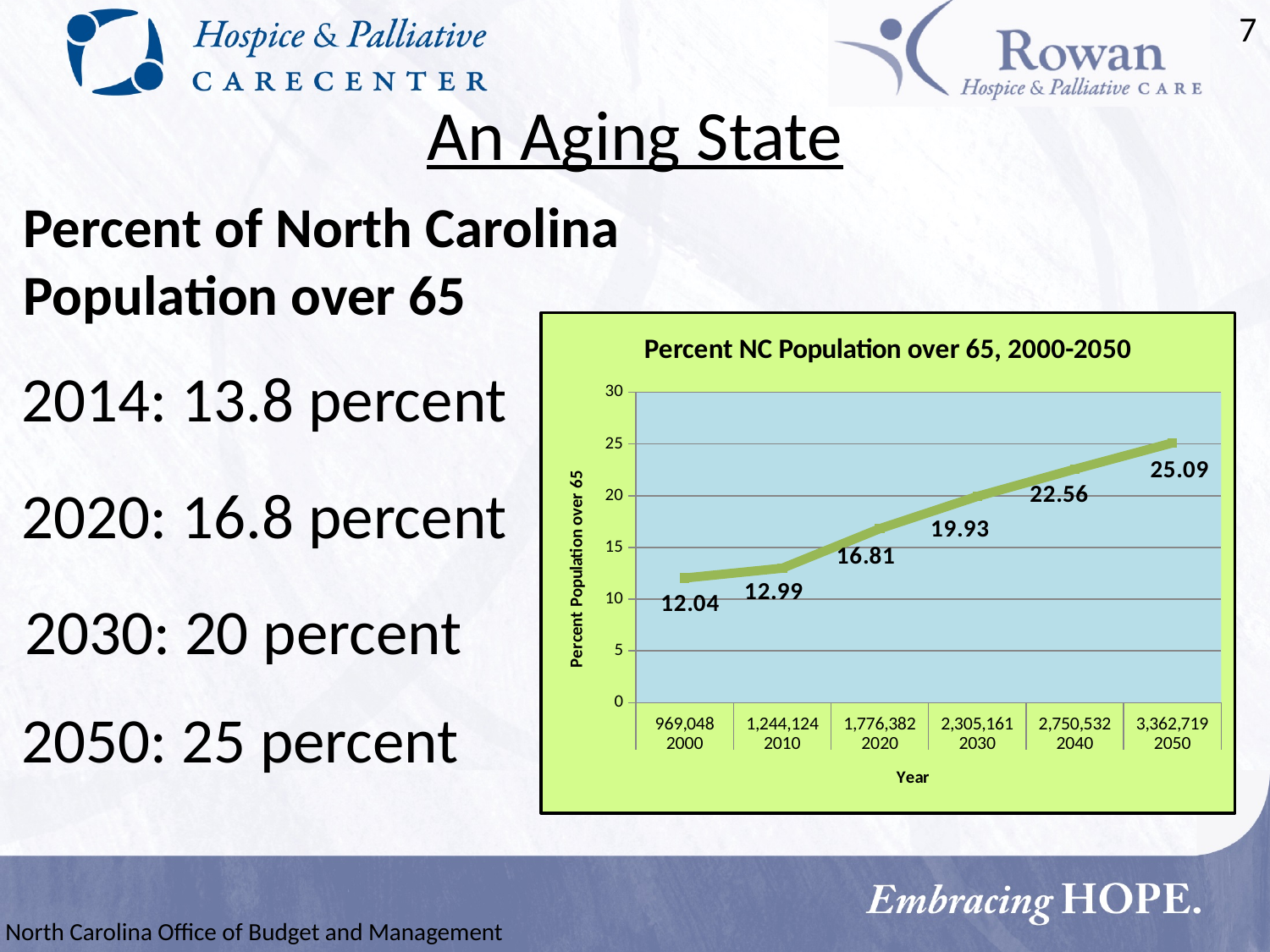
How many data points are plotted on the line? 6 What is the difference between the values for 2050 and 2000? 13.05 What is the plotted value for 2020? 16.81 Which year has the highest plotted value? 2050 What is the plotted value for 2040? 22.56 What is the plotted value for 2000? 12.04 Which year has the lowest plotted value? 2000 Do the values rise or fall from 2000 to 2050? Rise What type of chart is shown on the slide? Line chart What is the title of the chart? Percent NC Population over 65, 2000-2050 Is the value for 2030 greater or less than 15? greater Which is larger, the value for 2030 or the value for 2010? 2030